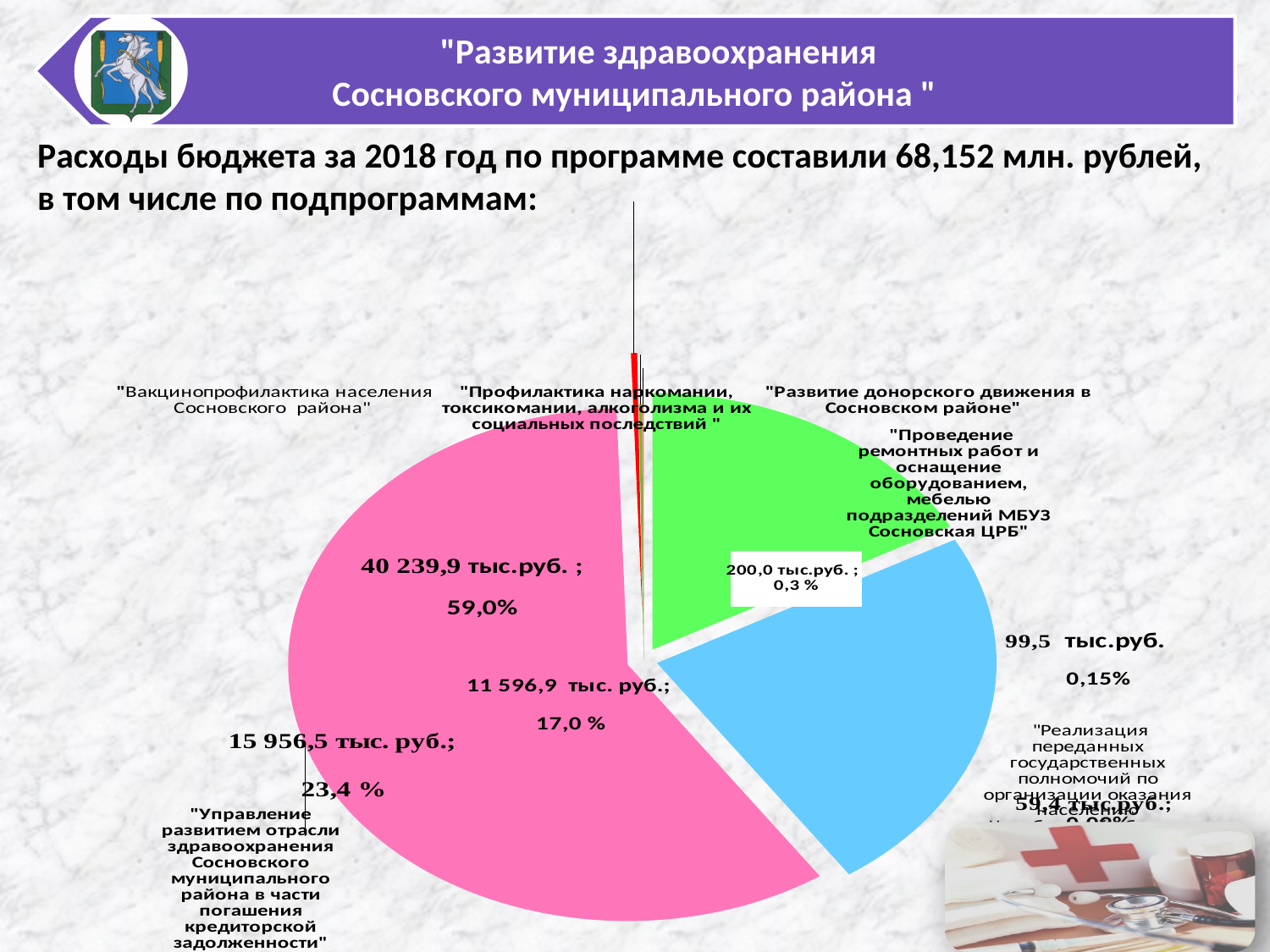
What is the largest share shown in the pie chart? 59,0% What share of the pie does the 15 956,5 тыс. руб. slice represent? 23,4 % What amount corresponds to the 17,0 % slice of the pie chart? 11 596,9 тыс. руб. According to the slide text, what were the total programme budget expenditures for 2018? 68,152 млн. рублей Which is larger: the 59,0% slice or the 23,4 % slice? the 59,0% slice What is the difference in thousand rubles between the 40 239,9 slice and the 15 956,5 slice? 24 283,4 тыс. руб. Which is larger: the 0,3 % slice or the 0,15% slice? the 0,3 % slice What kind of chart is shown on the slide? pie chart What amount in thousand rubles corresponds to the 59,0% slice of the pie chart? 40 239,9 тыс.руб. What share of the pie does the 99,5 тыс.руб. slice represent? 0,15% What share of the pie does the 200,0 тыс.руб. slice represent? 0,3 % How many subprogram slices are shown in the pie chart? 6